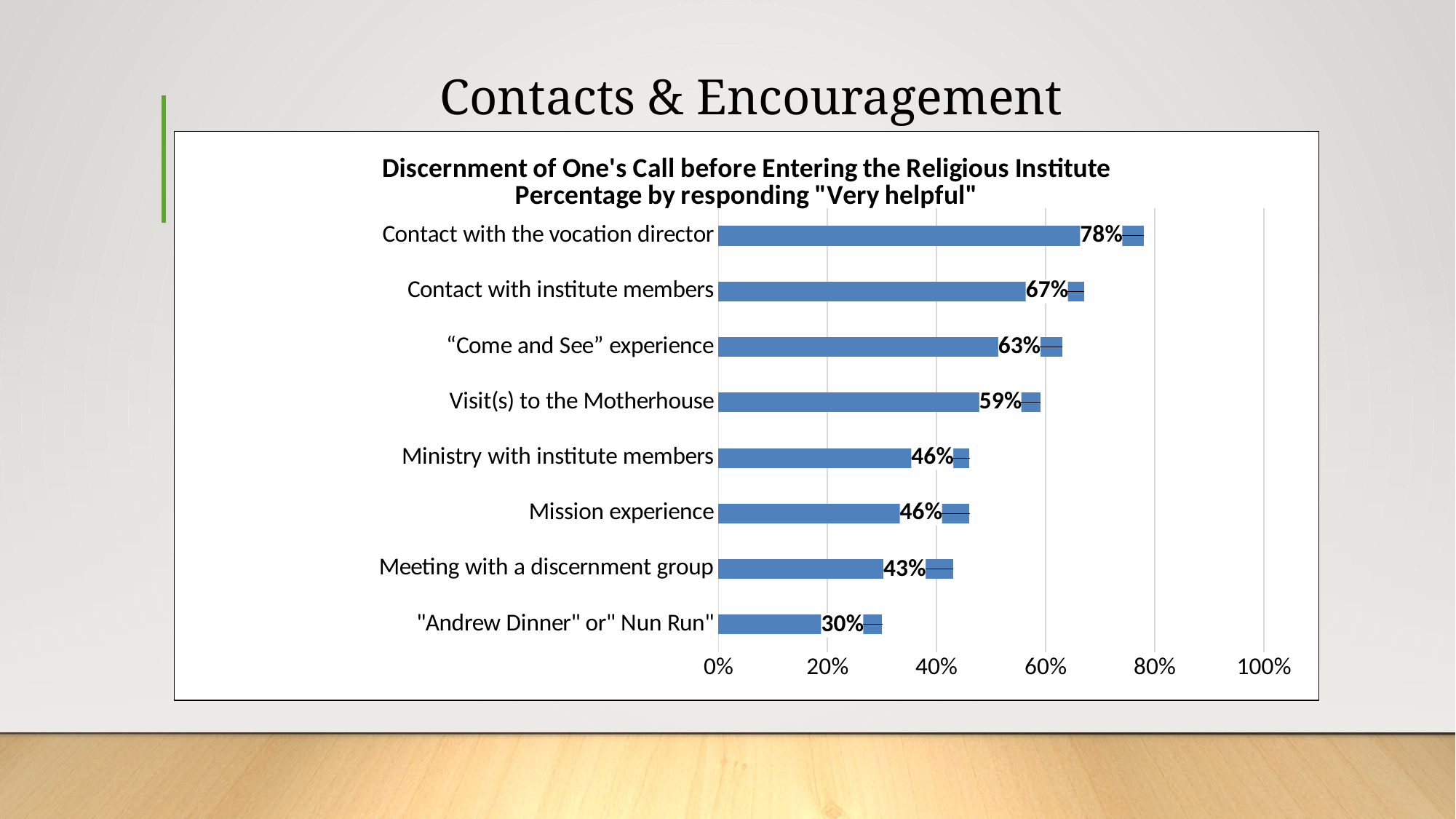
Which category has the highest percentage? Contact with the vocation director What is the value for "Andrew Dinner" or "Nun Run"? 30% Which category has the lowest percentage? "Andrew Dinner" or "Nun Run" What kind of chart is shown on the slide? Bar chart What is the title of the chart? Discernment of One's Call before Entering the Religious Institute Percentage by responding "Very helpful" What is the value for Visit(s) to the Motherhouse? 59% Is the value for Ministry with institute members greater or less than 40%? greater What percentage responded "Very helpful" for Contact with the vocation director? 78% Which is larger, Visit(s) to the Motherhouse or Mission experience? Visit(s) to the Motherhouse How many categories are shown in the chart? 8 What is the difference between Contact with the vocation director and Contact with institute members? 11% What is the difference between "Come and See" experience and Meeting with a discernment group? 20%